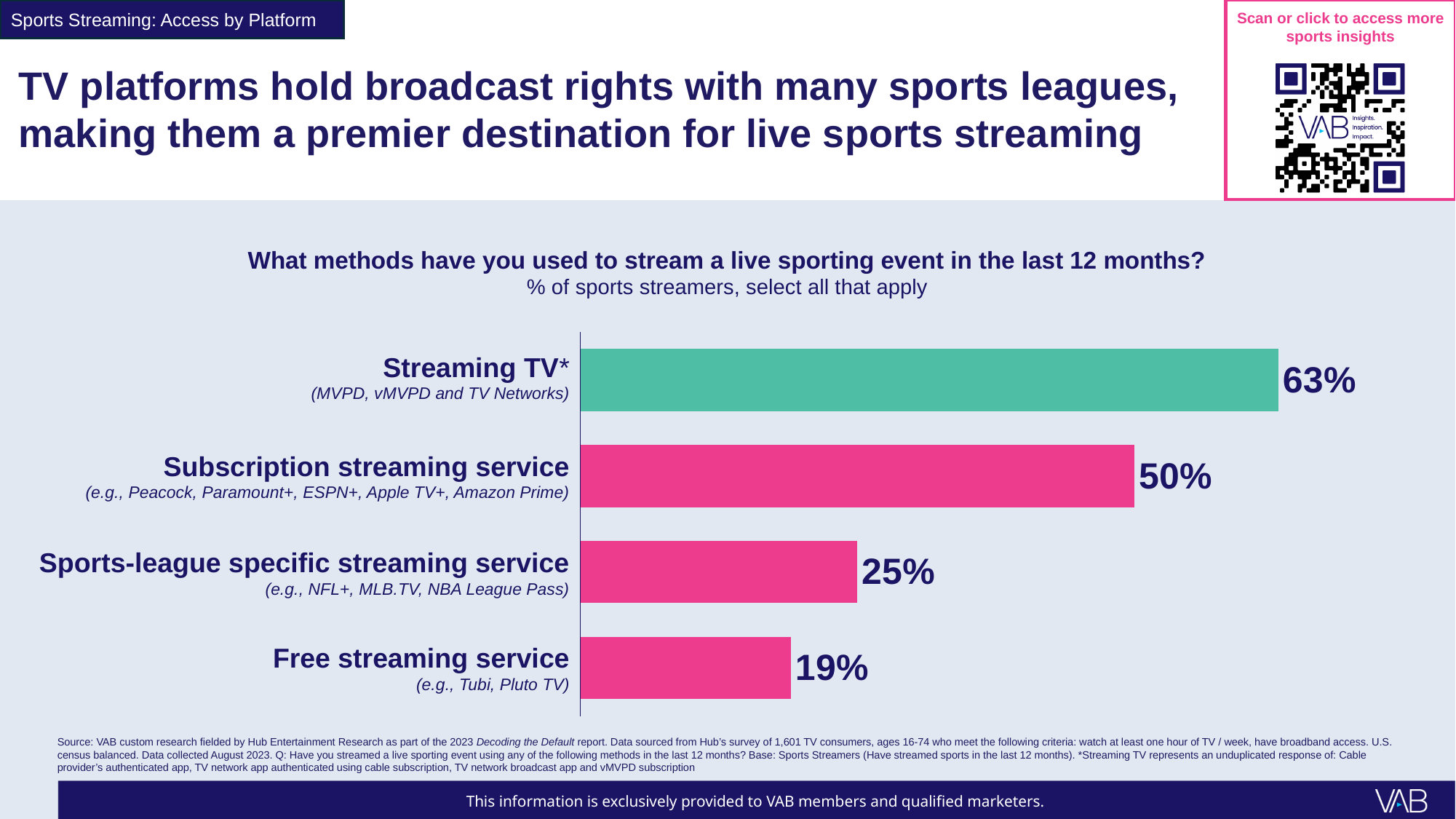
What is the difference in percentage points between Sports-league specific streaming service and Free streaming service? 6 Which method has the lowest percentage of sports streamers? Free streaming service What kind of chart is shown on the slide? Bar chart What percentage is shown for Sports-league specific streaming service? 25% What is the value for Free streaming service? 19% How many streaming methods are shown in the chart? 4 What is the value shown for Subscription streaming service? 50% Which method has the highest percentage of sports streamers? Streaming TV Which bar in the chart is coloured green rather than pink? Streaming TV What percentage of sports streamers used Streaming TV to stream a live sporting event? 63% What is the difference in percentage points between Streaming TV and Subscription streaming service? 13 Which is larger: the value for Subscription streaming service or Sports-league specific streaming service? Subscription streaming service